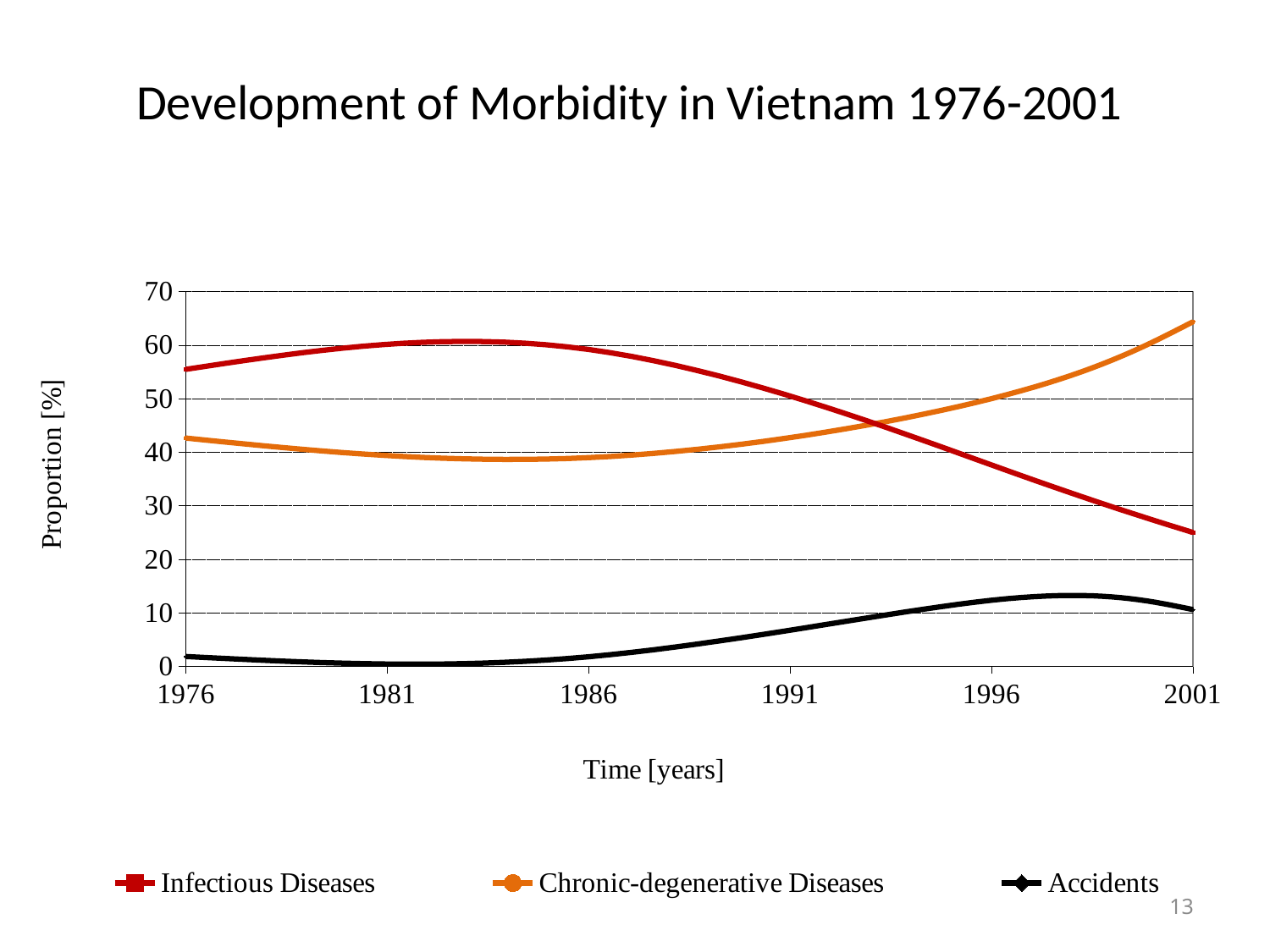
How many years are labelled on the x axis? 6 Is the value for Infectious Diseases in 1976 greater or less than 50? greater Does the Chronic-degenerative Diseases line rise or fall between 1986 and 2001? rise How many series does the legend list? 3 Does the Infectious Diseases line rise or fall between 1986 and 2001? fall Which series has the lowest value in 2001? Accidents What kind of chart is shown on the slide? line chart Is the value for Chronic-degenerative Diseases in 2001 greater or less than 60? greater Is the value for Accidents in 1976 greater or less than 10? less What is the title of the chart? Development of Morbidity in Vietnam 1976-2001 In 2001, which is larger: Infectious Diseases or Chronic-degenerative Diseases? Chronic-degenerative Diseases